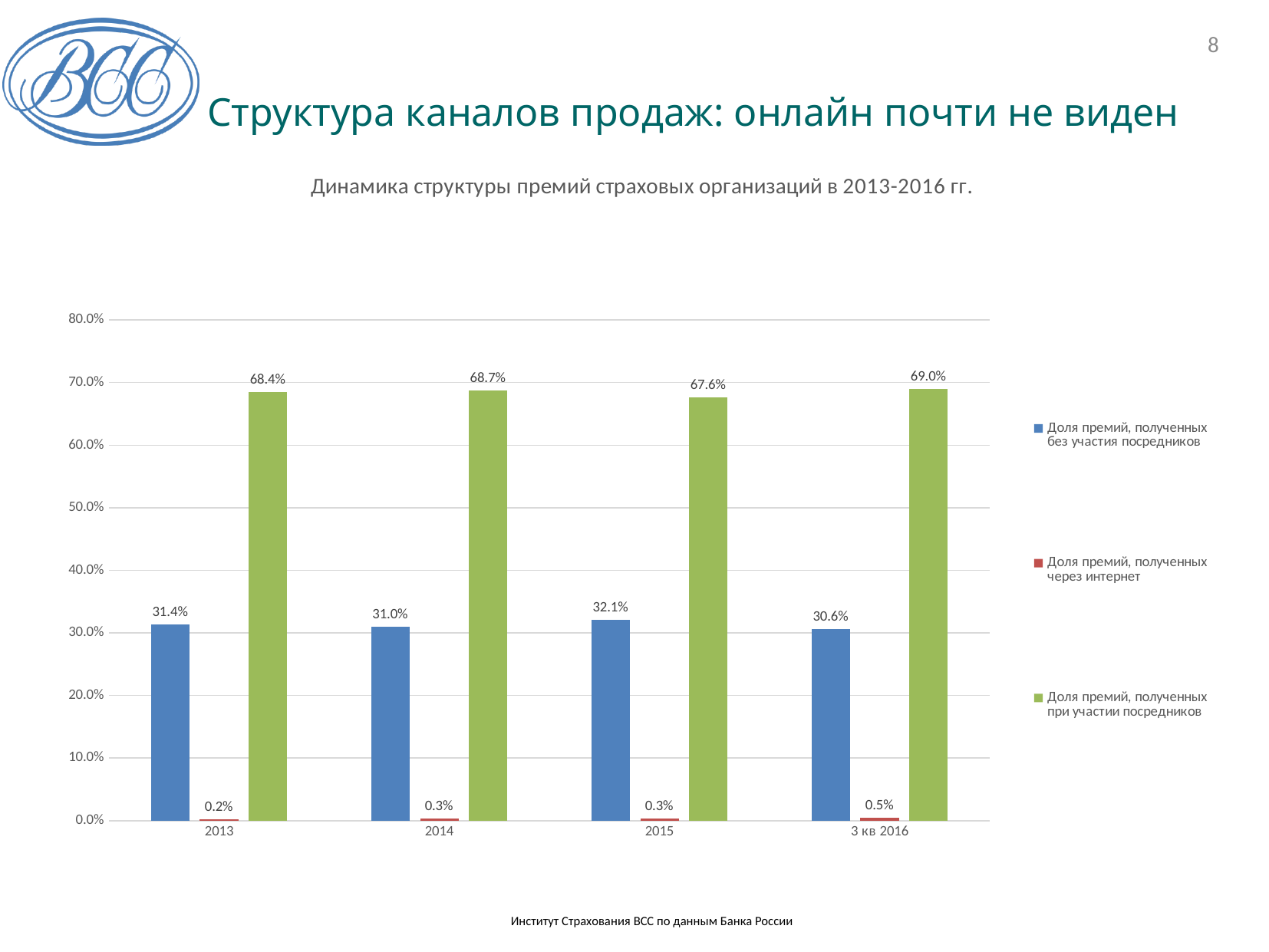
What is the share of premiums received with intermediaries (Доля премий, полученных при участии посредников) in 2015? 67.6% What is the share of premiums received without intermediaries (Доля премий, полученных без участия посредников) in 2013? 31.4% Is the share of premiums received with intermediaries in 2014 greater or less than 60.0%? greater In which period is the share of premiums received with intermediaries the highest? 3 кв 2016 Does the share of premiums received via the internet rise or fall from 2013 to 3 кв 2016? rise How many periods are shown on the x axis? 4 What is the share of premiums received via the internet (Доля премий, полученных через интернет) in 3 кв 2016? 0.5% In which period is the share of premiums received without intermediaries the lowest? 3 кв 2016 What kind of chart is shown on the slide? bar chart What is the difference between the share of premiums received with intermediaries in 2014 and in 2013? 0.3% Which is larger: the share of premiums received without intermediaries in 2015 or in 2014? 2015 How many series does the legend list? 3